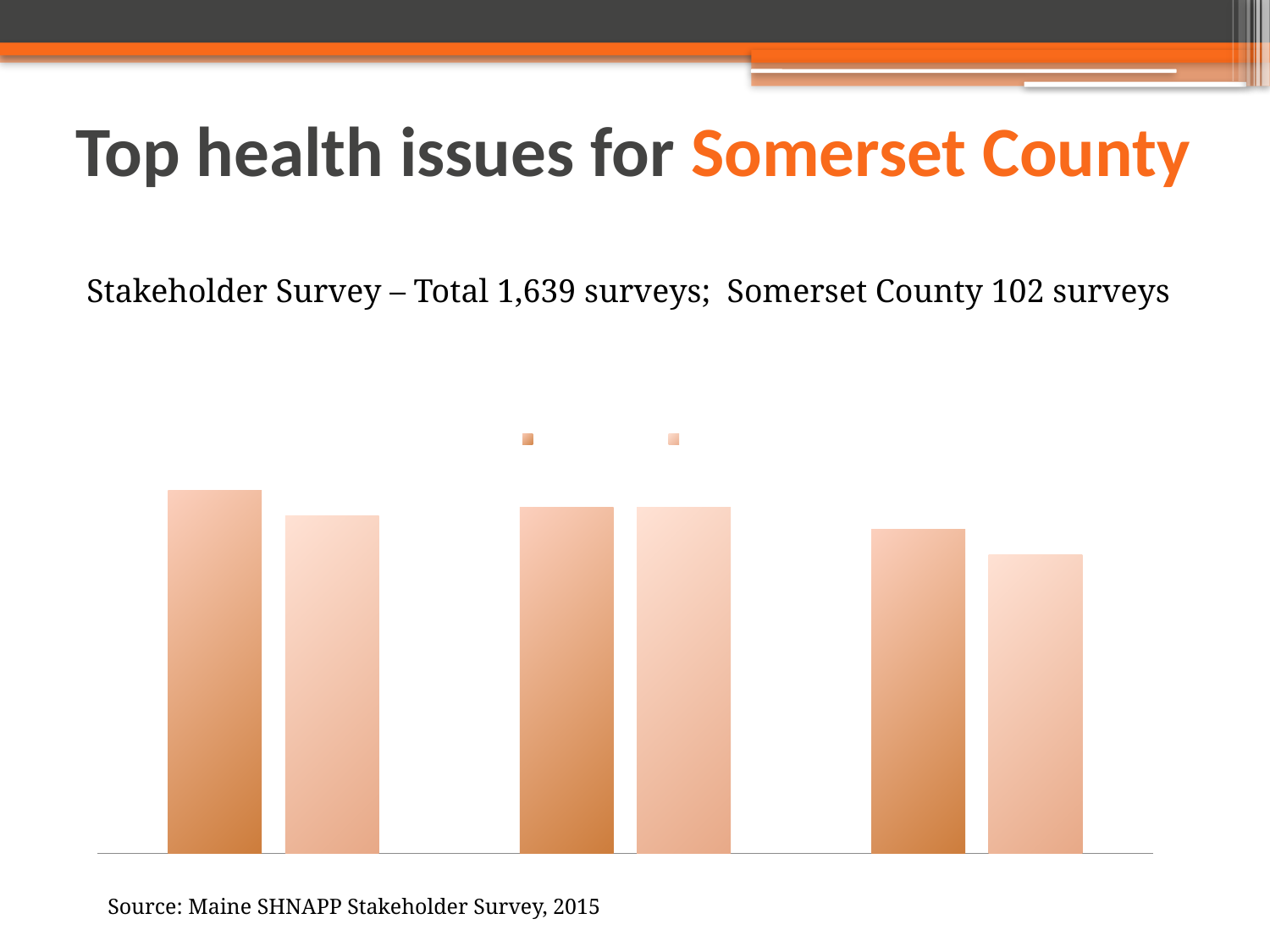
How many series does the chart's legend indicate? 2 In the leftmost group of bars, which bar is taller, the darker orange bar or the lighter peach bar? the darker orange bar Which group of bars contains the shortest bar on the chart? the rightmost group Which group of bars contains the tallest bar on the chart? the leftmost group Do the darker orange bars rise or fall from left to right across the three groups? fall How many bars are plotted in total on the chart? 6 What kind of chart is shown on the slide? bar chart What is the source cited below the chart? Maine SHNAPP Stakeholder Survey, 2015 How many groups of bars (categories) does the chart show? 3 Do the lighter peach bars rise or fall from left to right across the three groups? neither consistently; they rise from the first group to the second, then fall to the third In the rightmost group of bars, which bar is taller, the darker orange bar or the lighter peach bar? the darker orange bar